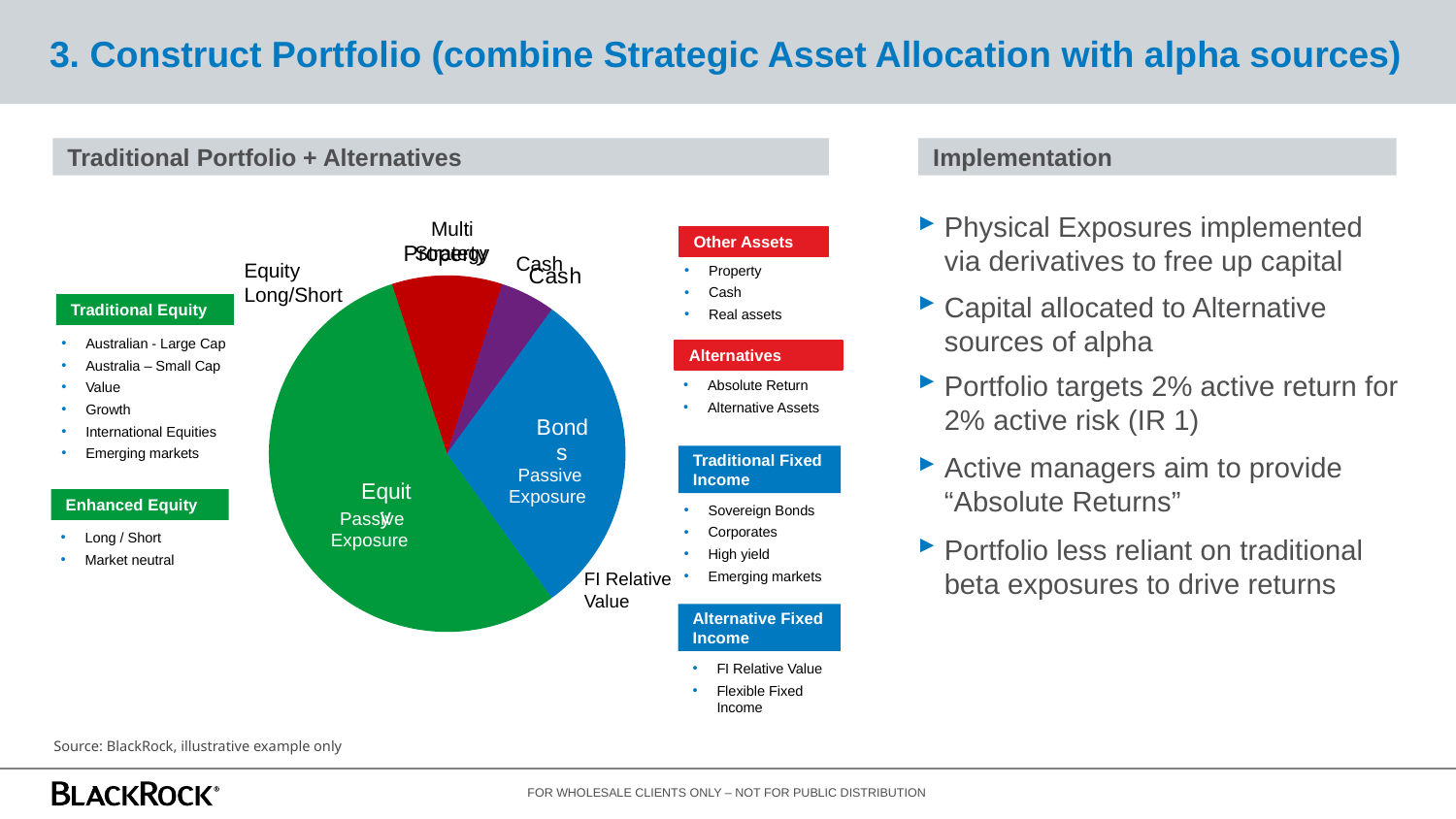
Which slice of the pie chart is the smallest? Cash What colour is the Bonds Passive Exposure slice in the pie chart? blue Which slice of the pie chart is the largest? Equity Passive Exposure How many slices does the pie chart have? 4 What kind of chart is shown on the slide? pie chart What colour is the Equity Passive Exposure slice in the pie chart? green Which is larger in the pie chart, the Equity Passive Exposure slice or the Bonds Passive Exposure slice? Equity Passive Exposure Which is larger in the pie chart, the Bonds Passive Exposure slice or the Cash slice? Bonds Passive Exposure